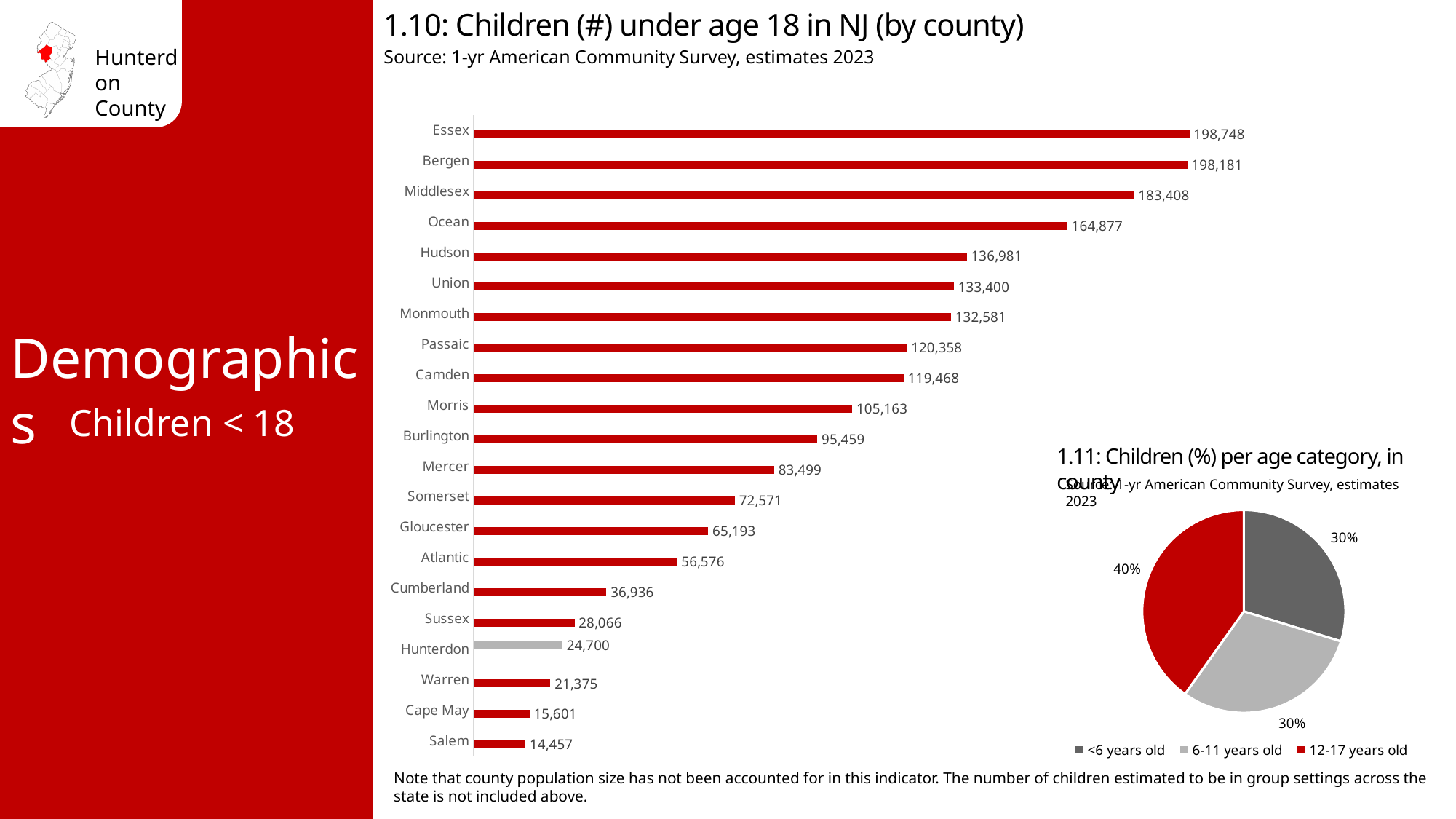
In the chart '1.10: Children (#) under age 18 in NJ (by county)', which county has the lowest value? Salem In the chart '1.10: Children (#) under age 18 in NJ (by county)', what is the value for Ocean? 164,877 In the chart '1.10: Children (#) under age 18 in NJ (by county)', how many counties are shown? 21 In the pie chart '1.11: Children (%) per age category, in county', how many age categories does the legend list? 3 In the chart '1.10: Children (#) under age 18 in NJ (by county)', what is the difference between the values for Warren and Cape May? 5,774 In the chart '1.10: Children (#) under age 18 in NJ (by county)', what is the difference between the values for Essex and Bergen? 567 In the chart '1.10: Children (#) under age 18 in NJ (by county)', which county's bar is shown in grey rather than red? Hunterdon In the chart '1.10: Children (#) under age 18 in NJ (by county)', which has a larger value, Morris or Burlington? Morris In the chart '1.10: Children (#) under age 18 in NJ (by county)', which county has the highest value? Essex In the chart '1.10: Children (#) under age 18 in NJ (by county)', what is the value for Hunterdon? 24,700 In the pie chart '1.11: Children (%) per age category, in county', what share is 12-17 years old? 40% What kind of chart is '1.10: Children (#) under age 18 in NJ (by county)'? Bar chart